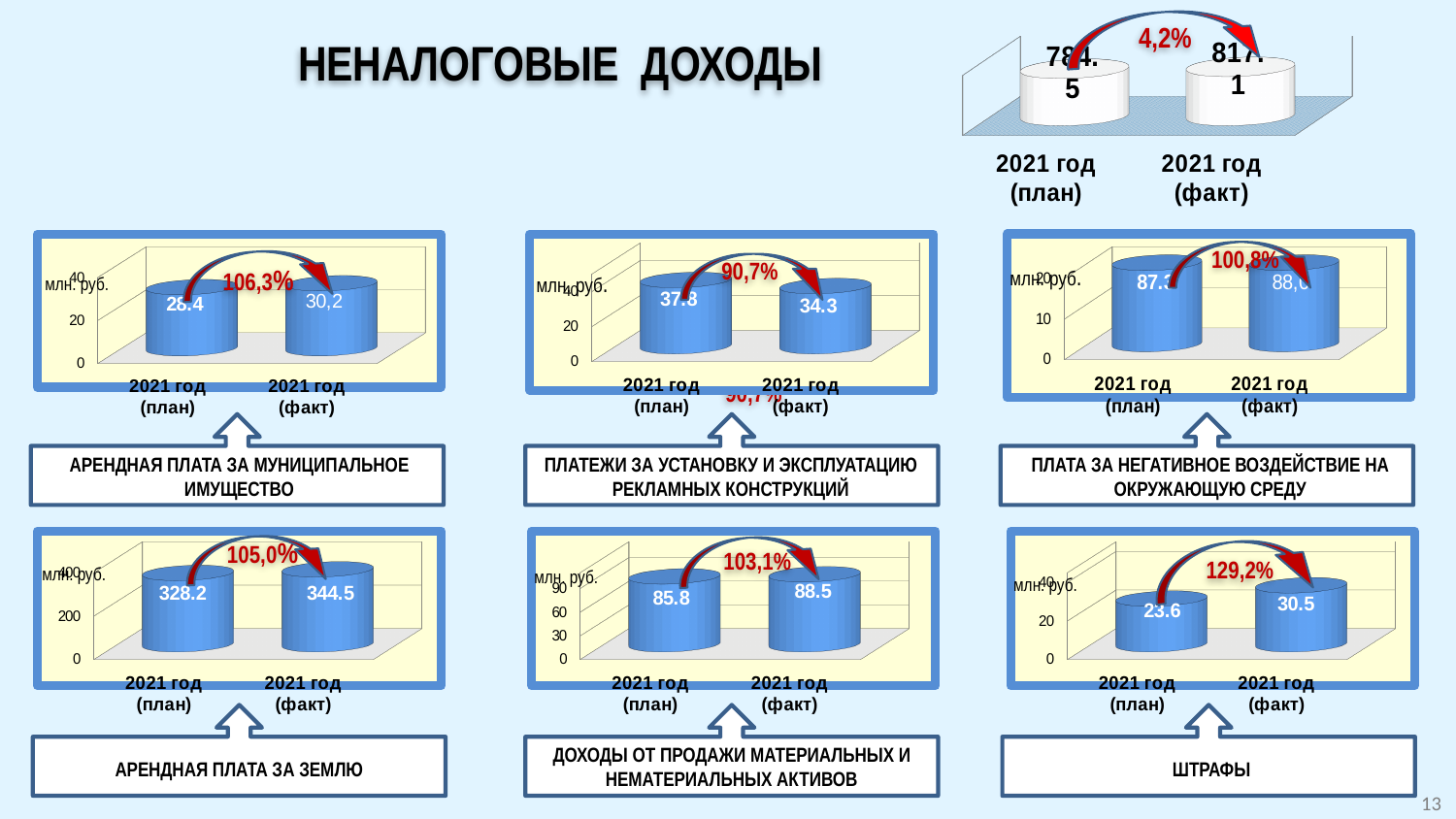
In the chart for АРЕНДНАЯ ПЛАТА ЗА ЗЕМЛЮ, what is the difference between the 2021 год (факт) and 2021 год (план) values? 16.3 In the chart for АРЕНДНАЯ ПЛАТА ЗА ЗЕМЛЮ, what is the value for 2021 год (факт)? 344.5 In the chart for ДОХОДЫ ОТ ПРОДАЖИ МАТЕРИАЛЬНЫХ И НЕМАТЕРИАЛЬНЫХ АКТИВОВ, what is the value for 2021 год (план)? 85.8 In the chart for ПЛАТЕЖИ ЗА УСТАНОВКУ И ЭКСПЛУАТАЦИЮ РЕКЛАМНЫХ КОНСТРУКЦИЙ, which is larger, 2021 год (план) or 2021 год (факт)? 2021 год (план) In the chart for ПЛАТЕЖИ ЗА УСТАНОВКУ И ЭКСПЛУАТАЦИЮ РЕКЛАМНЫХ КОНСТРУКЦИЙ, what is the difference between the 2021 год (план) and 2021 год (факт) values? 3.5 In the chart at the top right of the slide, what is the value for 2021 год (план)? 784.5 In the chart for ПЛАТА ЗА НЕГАТИВНОЕ ВОЗДЕЙСТВИЕ НА ОКРУЖАЮЩУЮ СРЕДУ, what is the value for 2021 год (план)? 87.3 In the chart for АРЕНДНАЯ ПЛАТА ЗА МУНИЦИПАЛЬНОЕ ИМУЩЕСТВО, what is the value for 2021 год (факт)? 30,2 In the chart for ШТРАФЫ, which category has the highest value? 2021 год (факт) How many categories does the chart for ШТРАФЫ show? 2 In the chart for АРЕНДНАЯ ПЛАТА ЗА МУНИЦИПАЛЬНОЕ ИМУЩЕСТВО, what percentage is shown on the arrow? 106,3% In the chart for ШТРАФЫ, what percentage is shown on the arrow? 129,2%